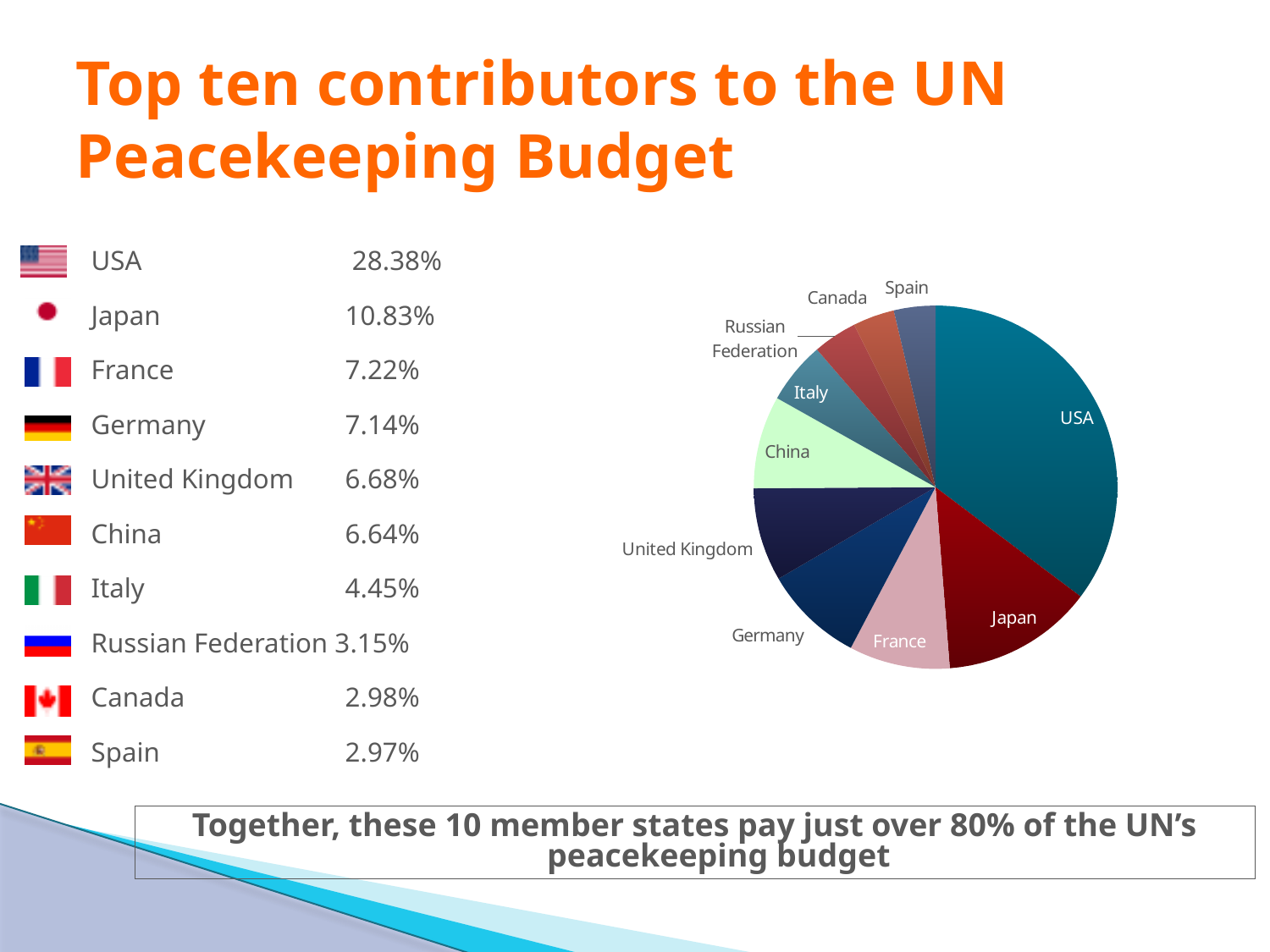
What is the difference between Canada's share and Spain's share? 0.01% What share of the UN peacekeeping budget does the United Kingdom contribute? 6.68% Which country has the smallest share listed on the slide? Spain How many slices does the pie chart have? 10 What share of the UN peacekeeping budget does the Russian Federation contribute? 3.15% What kind of chart is shown on the slide? pie chart Which contributes a larger share, China or Italy? China Which contributes a larger share, the USA or Japan? USA What share of the UN peacekeeping budget does the USA contribute? 28.38% Which country has the largest slice of the pie chart? USA What is the difference between the USA's share and Japan's share? 17.55% What share of the UN peacekeeping budget does Japan contribute? 10.83%